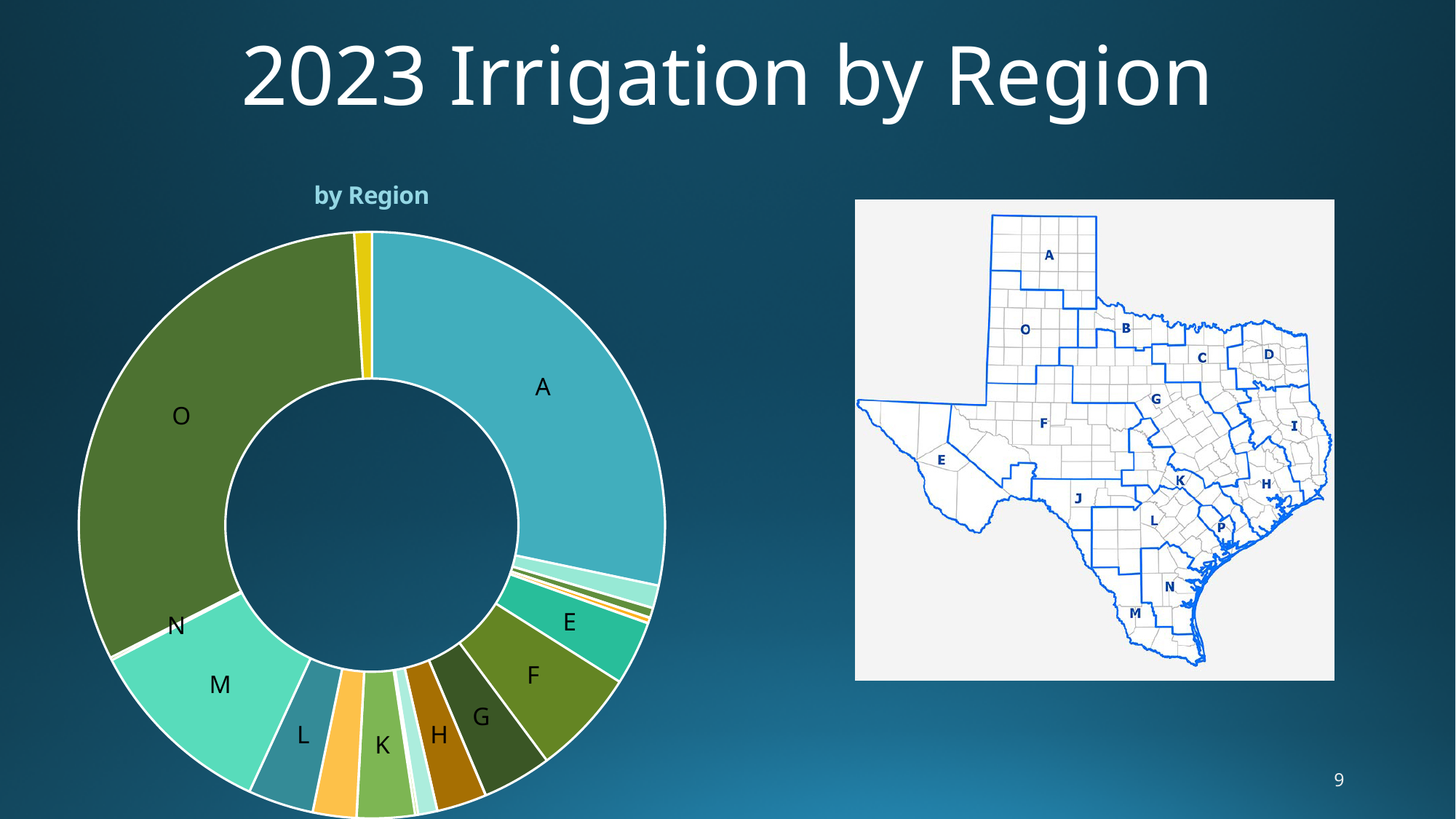
In the chart, which slice is larger, M or L? M In the chart, which slice is larger, A or K? A What colour is the slice labelled O in the chart? dark green What is the title of the chart on the slide? by Region What kind of chart is shown on the slide? doughnut chart In the chart, which slice is larger, F or G? F